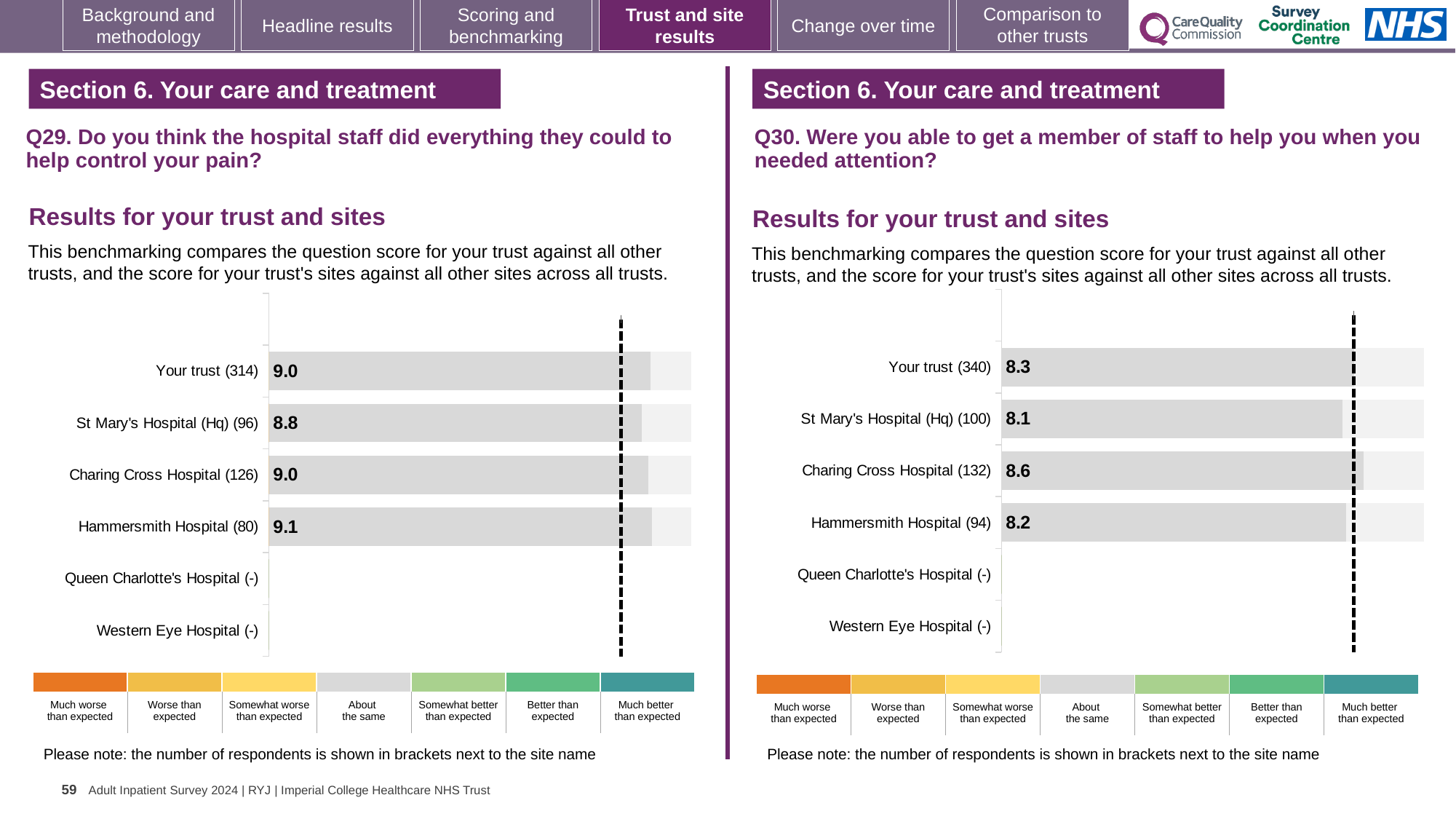
In the Q29 chart on the left, which site with a printed score has the lowest score? St Mary's Hospital (Hq) In the Q30 chart on the right, what is the score for Charing Cross Hospital? 8.6 In the Q29 chart on the left, which site has the highest score? Hammersmith Hospital In the Q29 chart on the left, what is the score for Your trust? 9.0 In the Q29 chart on the left, what is the score for St Mary's Hospital (Hq)? 8.8 In the Q30 chart on the right, what is the difference between the scores for Charing Cross Hospital and St Mary's Hospital (Hq)? 0.5 In the Q29 chart on the left, what is the difference between the scores for Hammersmith Hospital and St Mary's Hospital (Hq)? 0.3 In the Q30 chart on the right, what is the score for Hammersmith Hospital? 8.2 What kind of chart is used in the Q29 chart on the left? Bar chart In the Q30 chart on the right, which site has the highest score? Charing Cross Hospital In the Q30 chart on the right, which site with a printed score has the lowest score? St Mary's Hospital (Hq) In the Q30 chart on the right, which is larger: the score for Your trust or the score for Charing Cross Hospital? Charing Cross Hospital